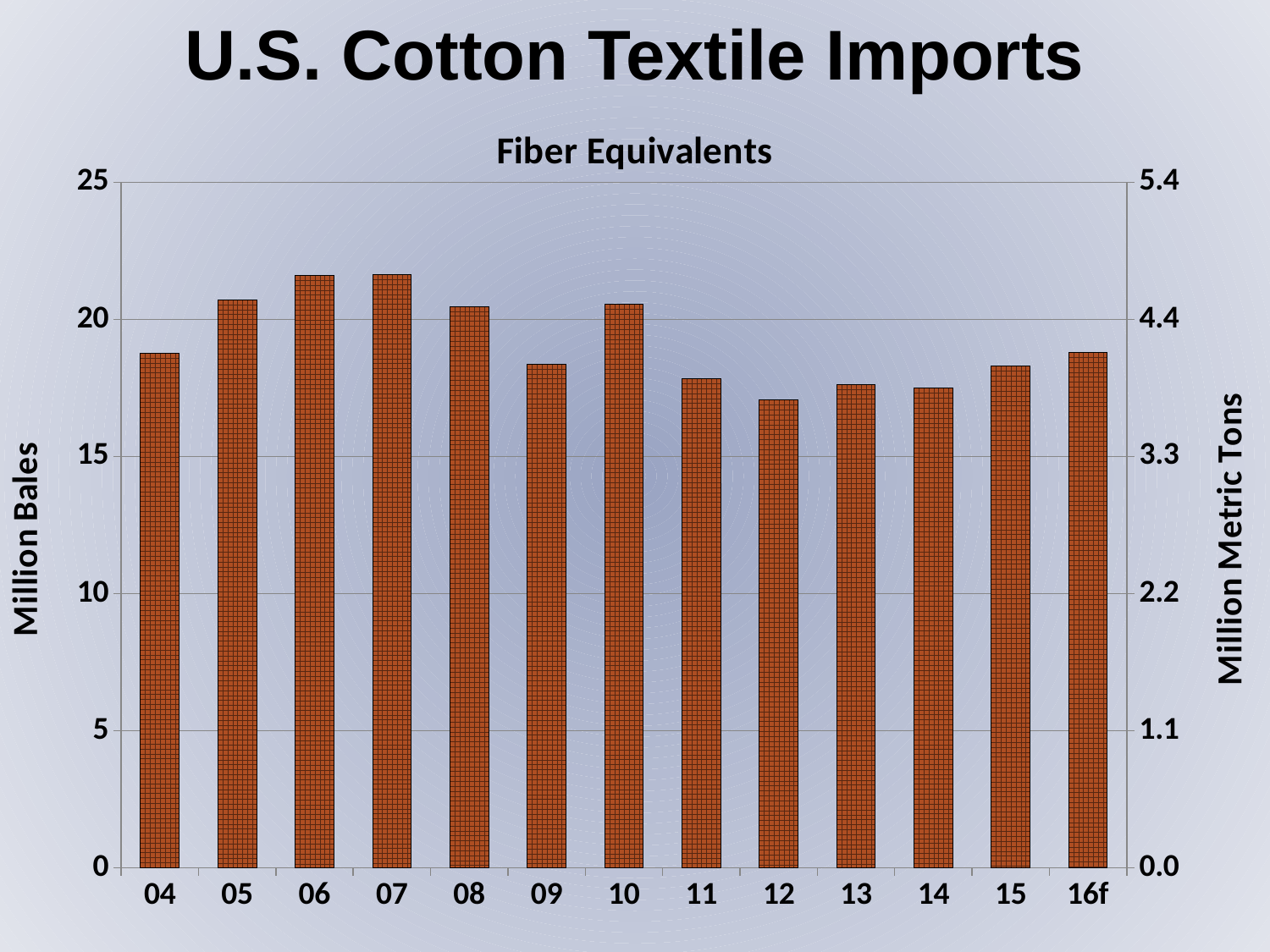
Which is larger, the value for 08 or the value for 14? 08 Is the value for 12 greater or less than 20 million bales? less Which is larger, the value for 05 or the value for 12? 05 Is the value for 04 greater or less than 15 million bales? greater Which year has the lowest value for U.S. cotton textile imports? 12 What is the label of the left vertical axis? Million Bales What is the label of the right vertical axis? Million Metric Tons How many years (categories) are shown on the x axis? 13 What kind of chart is shown on the slide? bar chart Is the value for 11 greater or less than 20 million bales? less Do the values rise or fall from 07 to 09? fall